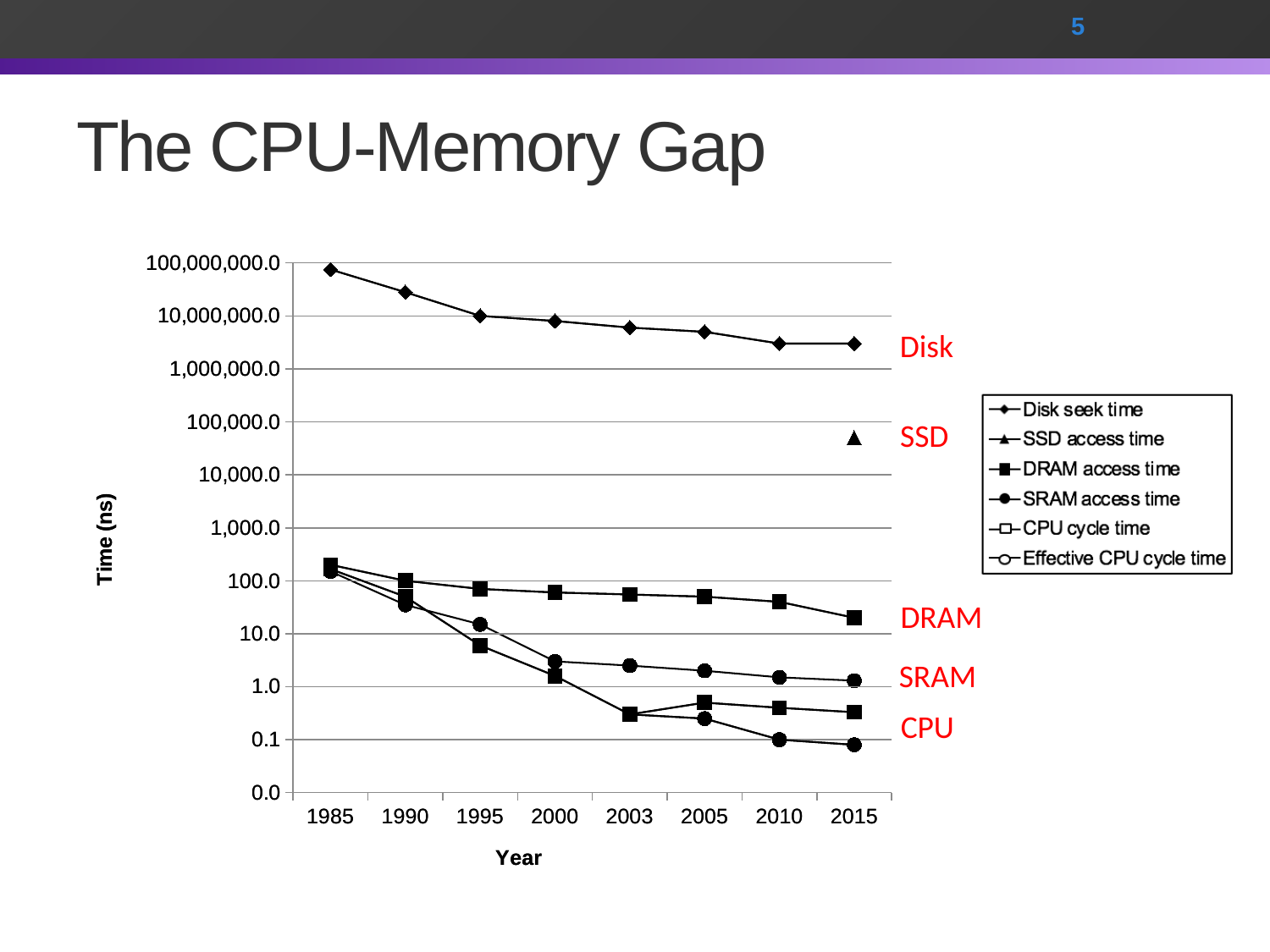
How many years are shown on the x axis? 8 Is the Disk seek time in 2015 greater or less than 10,000,000? less Is the Disk seek time in 1985 greater or less than 10,000,000? greater What kind of chart is shown on the slide? line chart What is the title of the x axis? Year Does the Disk seek time rise or fall from 1985 to 2015? fall Which series has the highest value in 1985? Disk seek time How many series does the legend list? 6 Is the DRAM access time in 2015 greater or less than 100? less What is the title of the y axis? Time (ns) In 2015, which is larger: DRAM access time or SRAM access time? DRAM access time